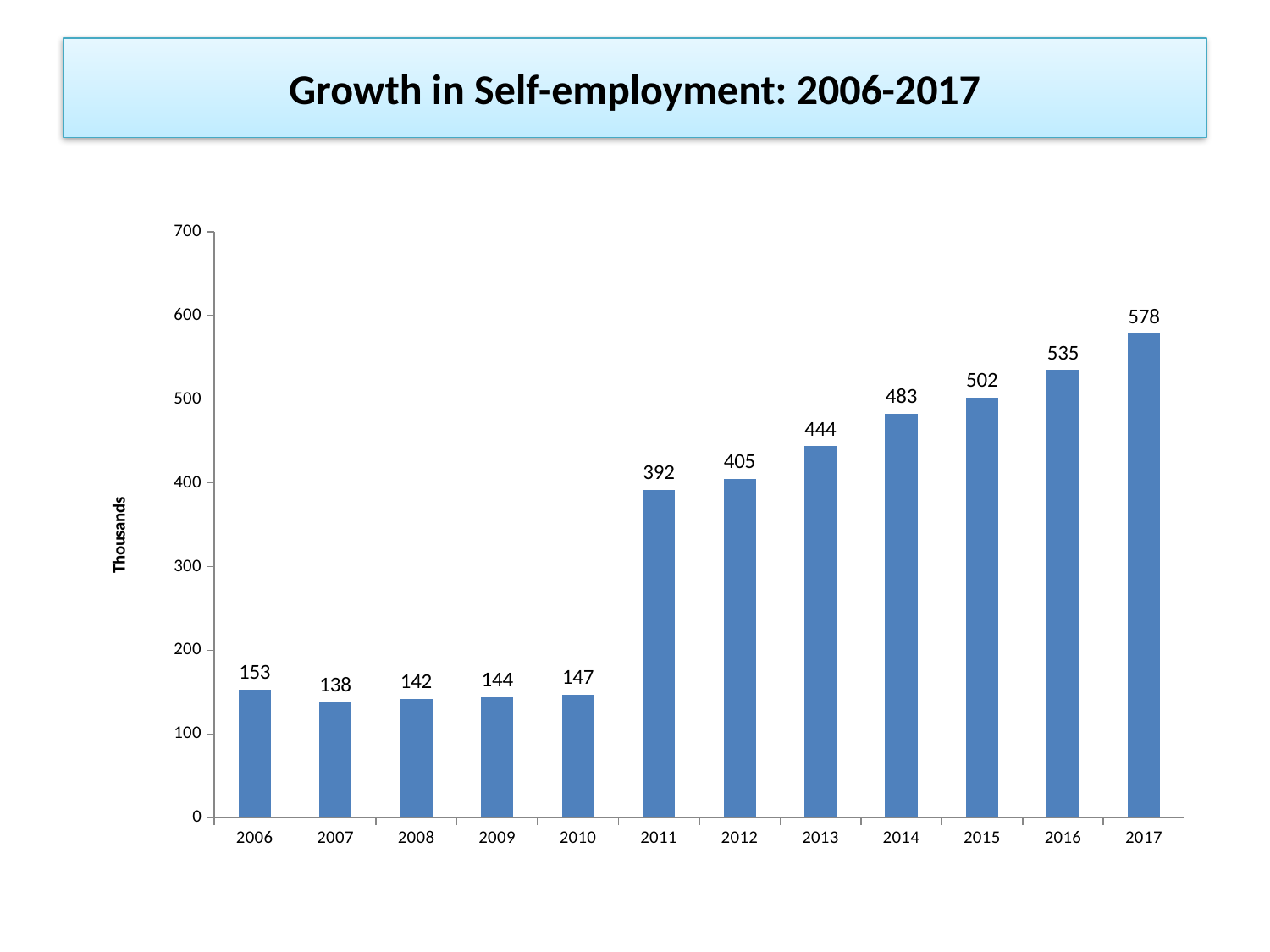
What is the value for 2011? 392 Which year has the highest value? 2017 How many years are shown on the x axis? 12 What is the title of the chart? Growth in Self-employment: 2006-2017 Which is larger, the value for 2013 or the value for 2012? 2013 Is the value for 2015 greater or less than 400? greater What kind of chart is shown on the slide? bar chart What is the difference between the values for 2017 and 2016? 43 Which year has the lowest value? 2007 What is the difference between the values for 2011 and 2010? 245 What is the value for 2006? 153 Do the values generally rise or fall from 2011 to 2017? rise